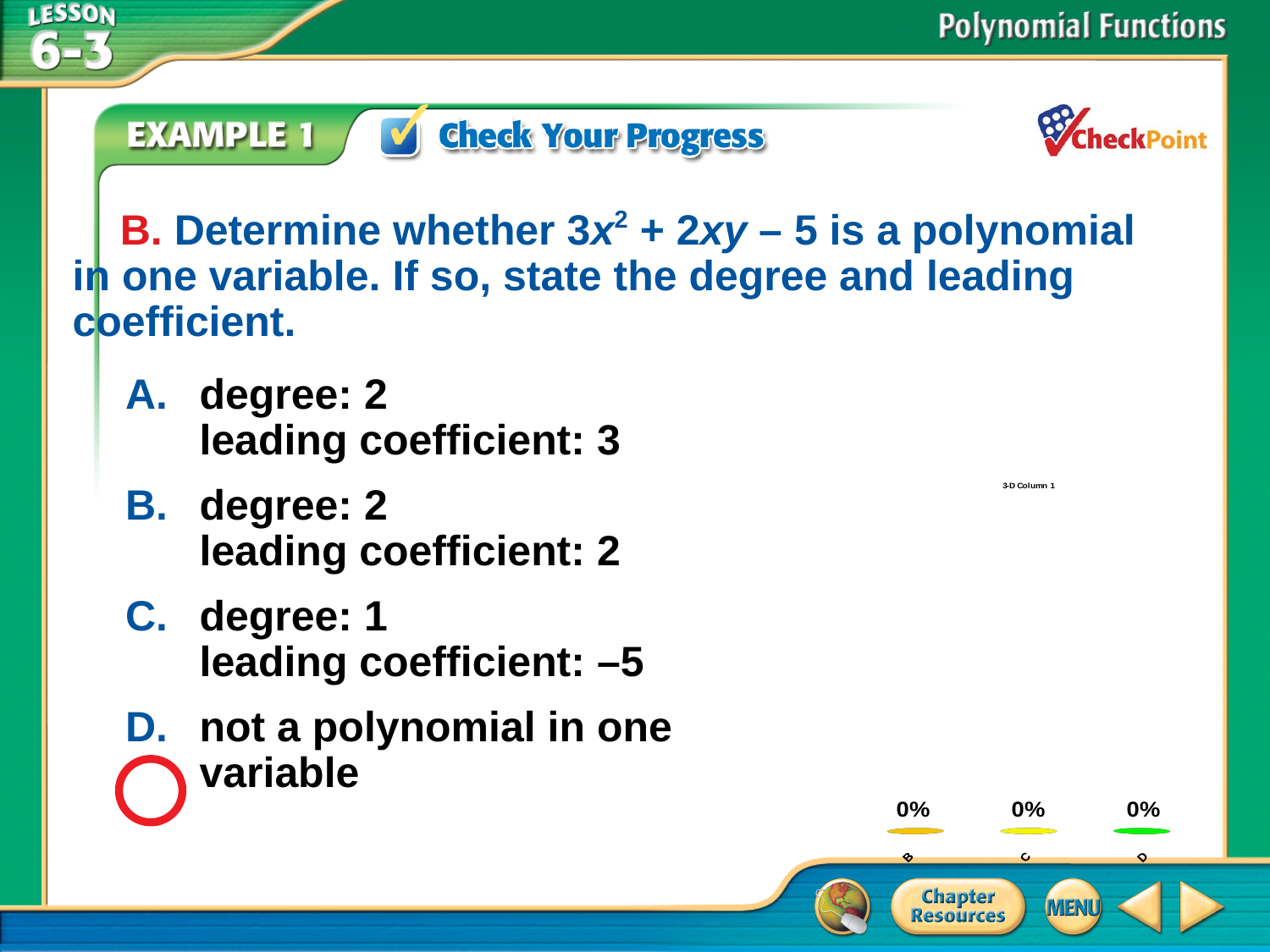
What is the value shown for category B in the chart? 0% What colour is the bar for category D in the chart? green What is the value shown for category C in the chart? 0% What kind of chart is shown at the bottom right of the slide? bar chart What is the title of the chart on the slide? 3-D Column 1 What is the value shown for category D in the chart? 0% Are the values for B, C and D in the chart all the same? yes What is the difference between the values for B and D in the chart? 0%